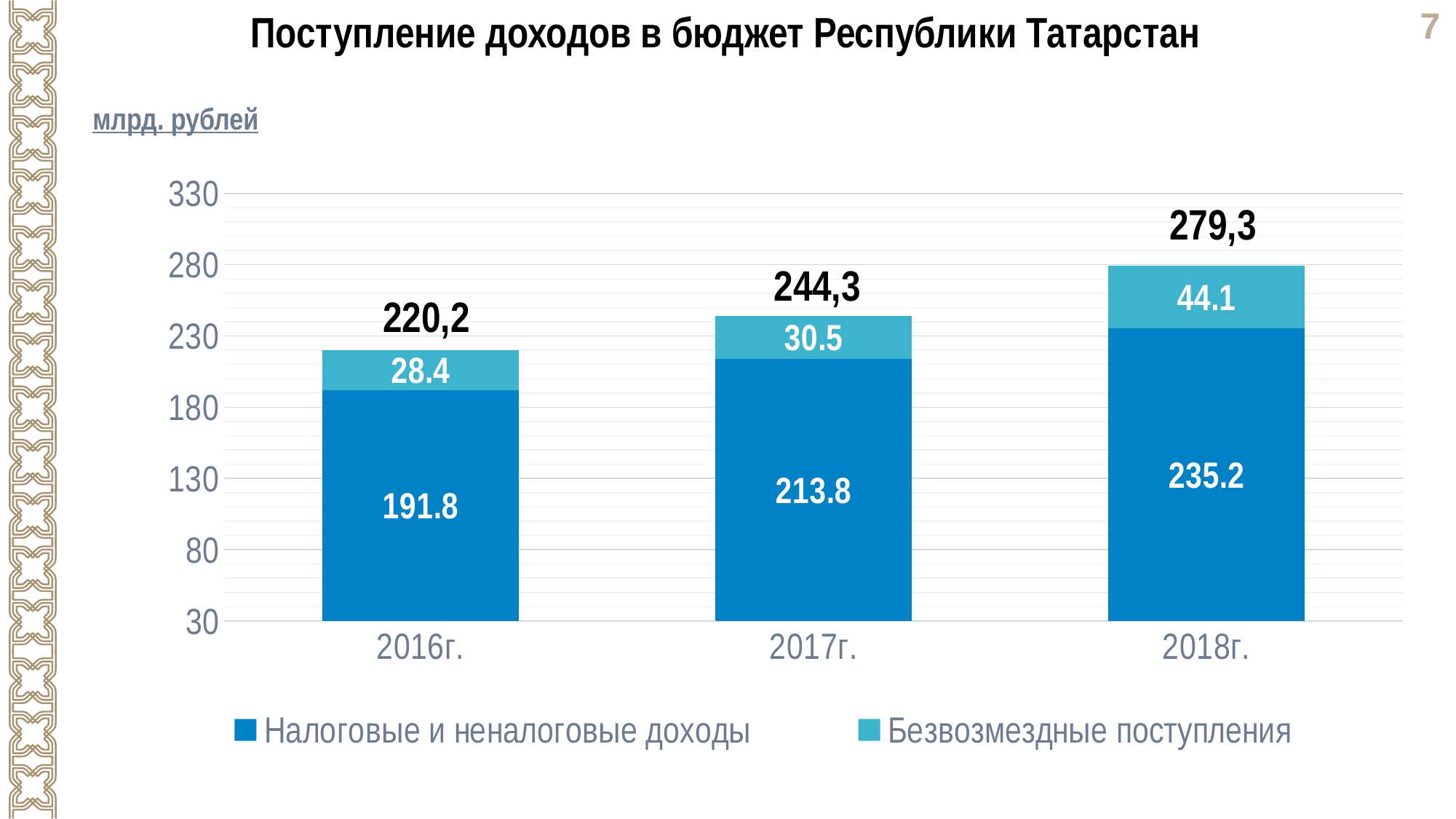
Which year has the lowest value for Безвозмездные поступления? 2016г. What is the value of Безвозмездные поступления for 2016г.? 28.4 How many series does the legend list? 2 Which year has the highest value for Налоговые и неналоговые доходы? 2018г. Do the bar totals rise or fall from 2016г. to 2018г.? rise How many years are shown on the x axis? 3 What is the difference between Налоговые и неналоговые доходы in 2018г. and 2017г.? 21.4 What is the value of Безвозмездные поступления for 2018г.? 44.1 What is the value of Налоговые и неналоговые доходы for 2017г.? 213.8 What is the total shown above the bar for 2018г.? 279,3 Which is larger: Безвозмездные поступления in 2017г. or in 2018г.? 2018г. What is the total shown above the bar for 2016г.? 220,2